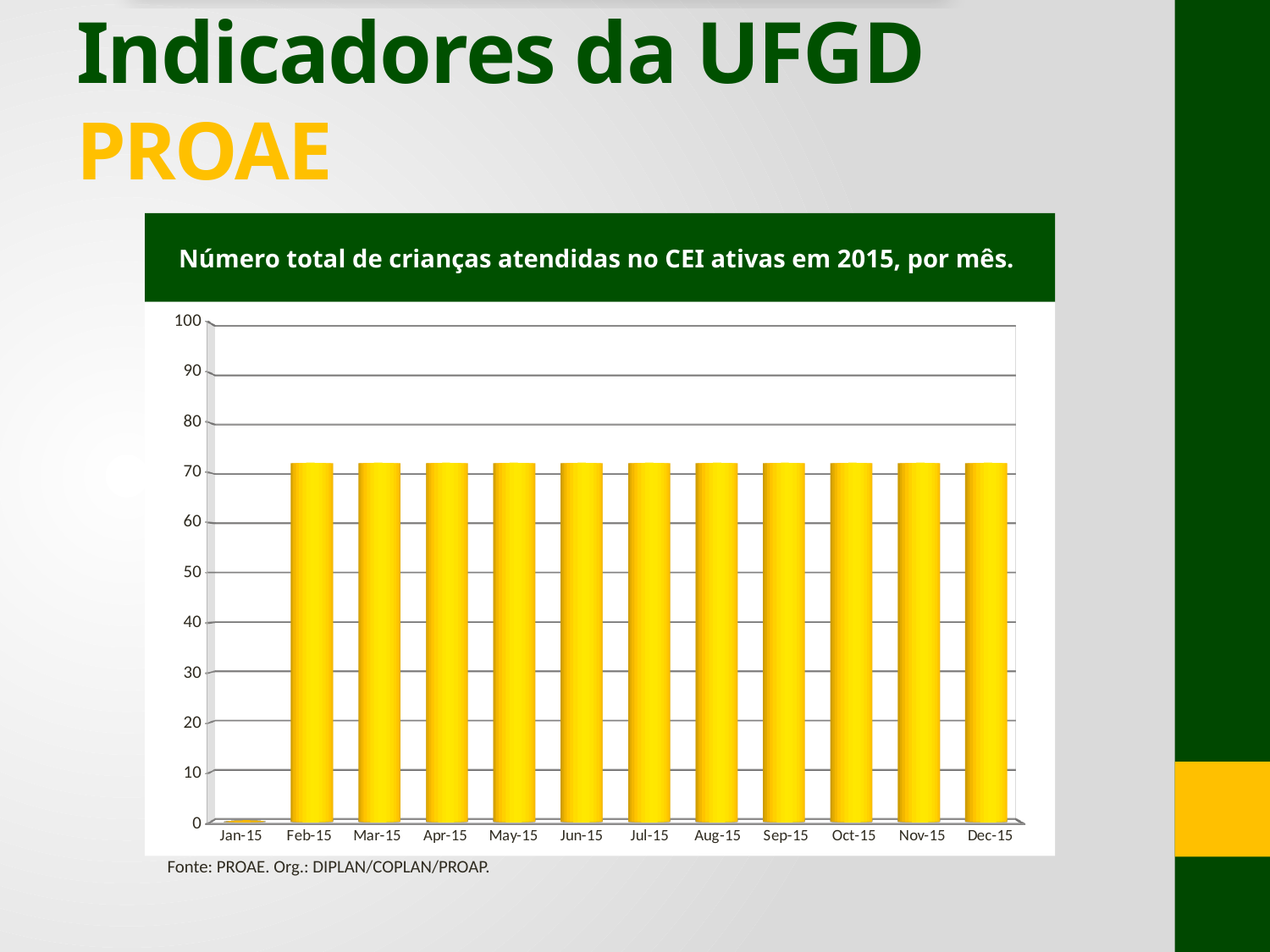
Is the value for Jul-15 greater or less than 50? greater How many months are shown on the x axis of the chart? 12 Which month has the lowest value in the chart? Jan-15 What kind of chart is shown on the slide? bar chart Is the value for Feb-15 greater or less than 60? greater What is the title of the chart? Número total de crianças atendidas no CEI ativas em 2015, por mês. Is the value for Dec-15 greater or less than 80? less What colour are the bars in the chart? yellow Which is larger, the value for Jan-15 or the value for Mar-15? Mar-15 Do the values rise or fall from Jan-15 to Feb-15? rise What is the value for Jan-15? 0